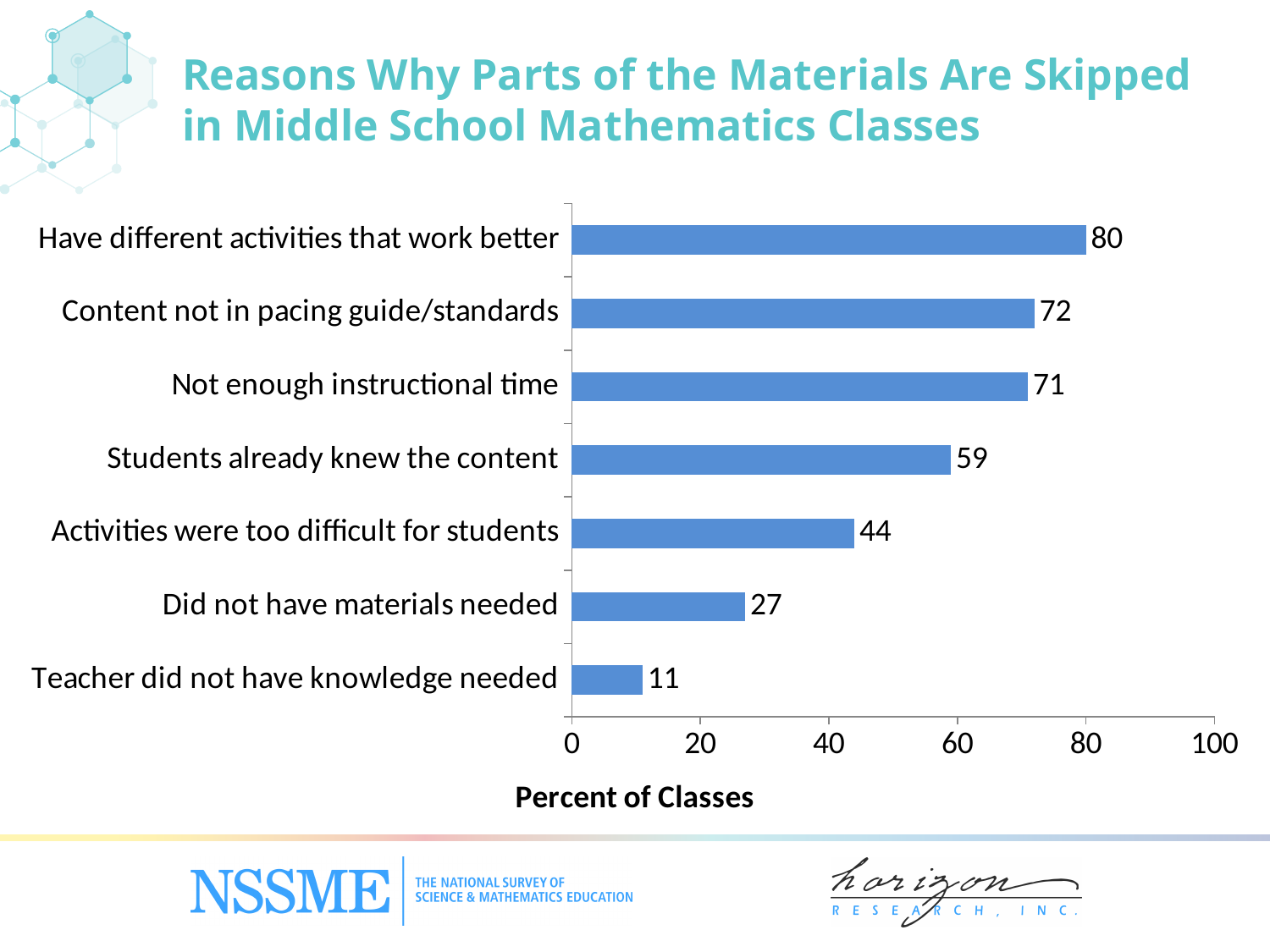
What is the difference between 'Have different activities that work better' and 'Teacher did not have knowledge needed'? 69 What is the difference between 'Content not in pacing guide/standards' and 'Activities were too difficult for students'? 28 How many reasons are shown in the chart? 7 Which is larger: 'Students already knew the content' or 'Did not have materials needed'? Students already knew the content What is the label of the horizontal axis? Percent of Classes What is the value for 'Did not have materials needed'? 27 Is the value for 'Activities were too difficult for students' greater or less than 40? greater Which reason has the highest percent of classes? Have different activities that work better What is the value for 'Students already knew the content'? 59 Which reason has the lowest percent of classes? Teacher did not have knowledge needed What percent of classes skip parts of the materials because they have different activities that work better? 80 What kind of chart is shown on the slide? Bar chart